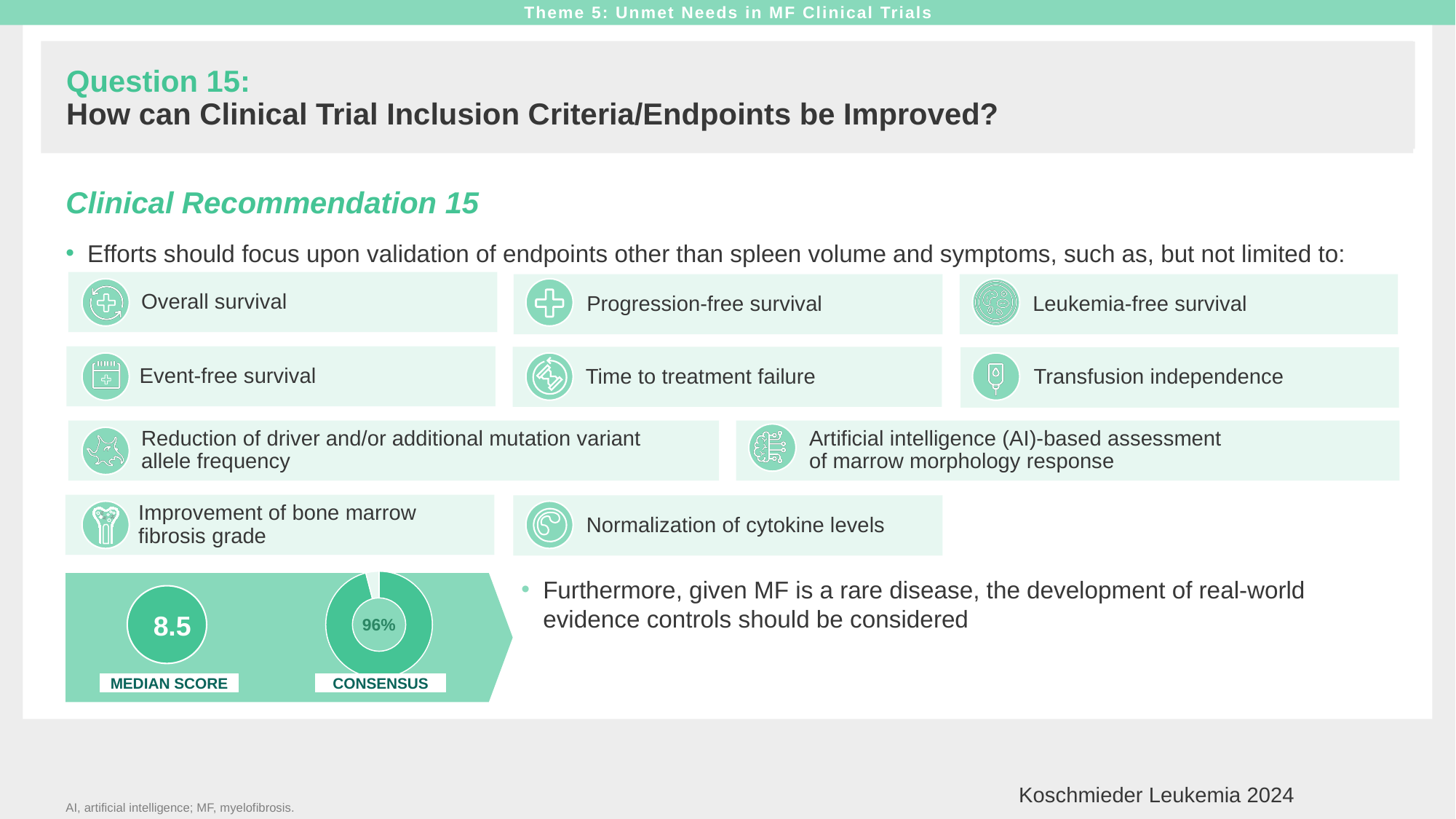
What consensus percentage is shown in the donut chart? 96% What label appears beneath the circle showing 8.5? MEDIAN SCORE What share of the donut chart does the filled consensus segment represent? 96% What kind of chart is used to display the consensus value at the bottom left of the slide? pie chart (donut) What median score is shown in the circle next to the consensus chart? 8.5 What label appears beneath the donut chart? CONSENSUS How many segments does the consensus donut chart have? 2